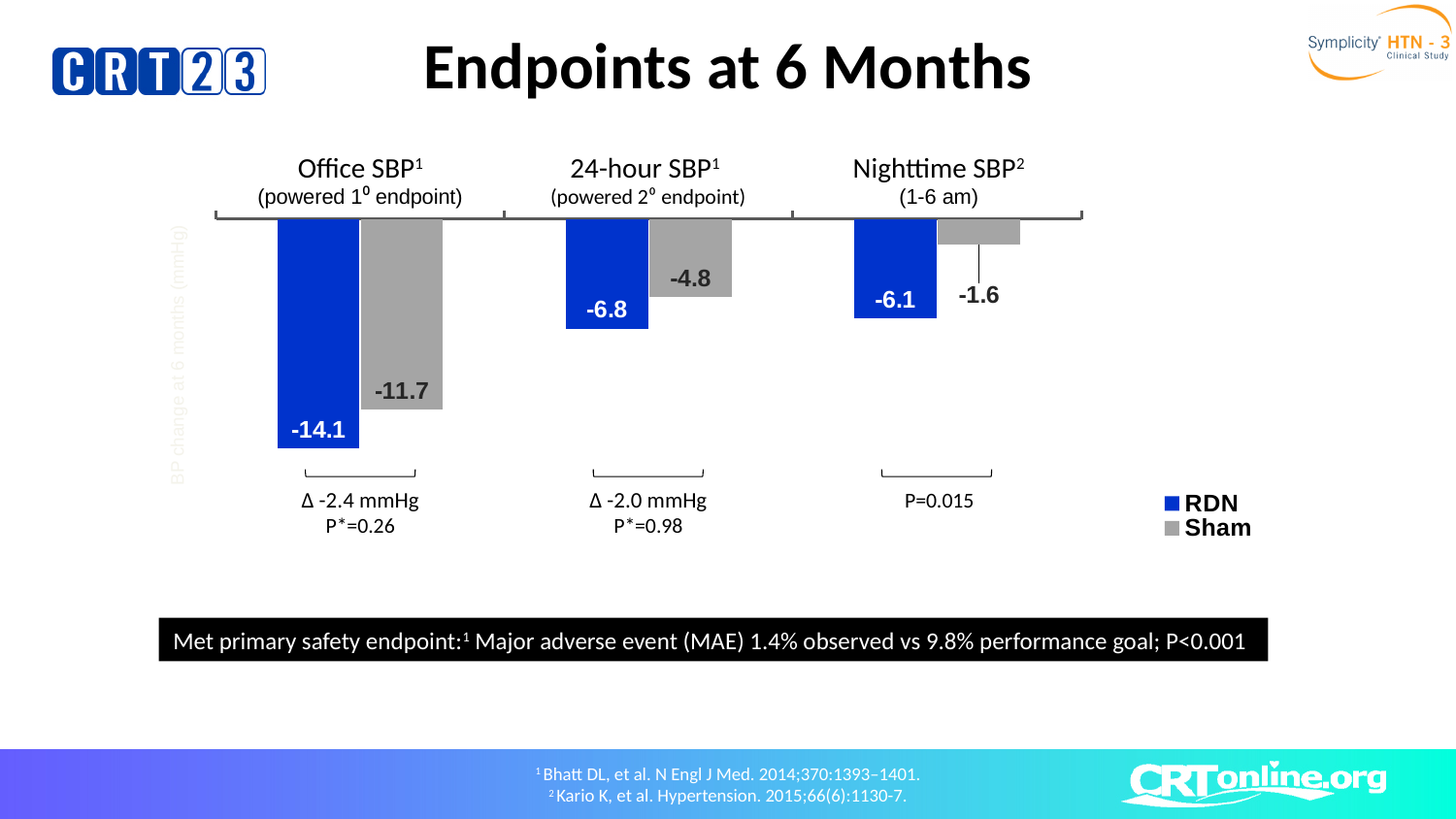
What is the RDN value for Nighttime SBP? -6.1 What is the Sham value for Nighttime SBP? -1.6 Which category has the smallest Sham change in magnitude? Nighttime SBP For Nighttime SBP, which series shows the larger reduction, RDN or Sham? RDN Which category has the largest (most negative) RDN change? Office SBP How many categories are shown on the x axis? 3 What is the Sham value for Office SBP? -11.7 What is the RDN value for 24-hour SBP? -6.8 What is the RDN value for Office SBP? -14.1 How many series does the legend list? 2 What is the difference between the RDN and Sham values for 24-hour SBP? 2.0 What kind of chart is shown on the slide? Bar chart